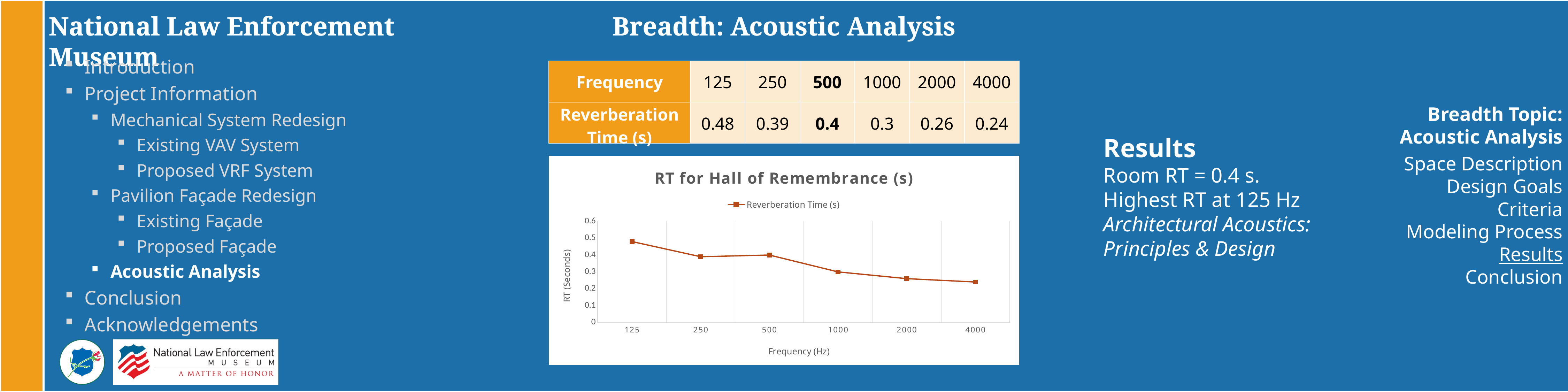
What is the reverberation time at 125 Hz? 0.48 What is the reverberation time at 1000 Hz? 0.3 Does the reverberation time generally rise or fall as frequency increases? fall What is the reverberation time at 500 Hz? 0.4 How many frequency points are plotted on the chart? 6 At which frequency is the reverberation time lowest? 4000 What type of chart is shown on the slide? line chart Which has a higher reverberation time, 125 Hz or 4000 Hz? 125 Hz How many series does the chart legend list? 1 Is the reverberation time at 2000 Hz greater or less than 0.3? less At which frequency is the reverberation time highest? 125 What is the title of the chart? RT for Hall of Remembrance (s)